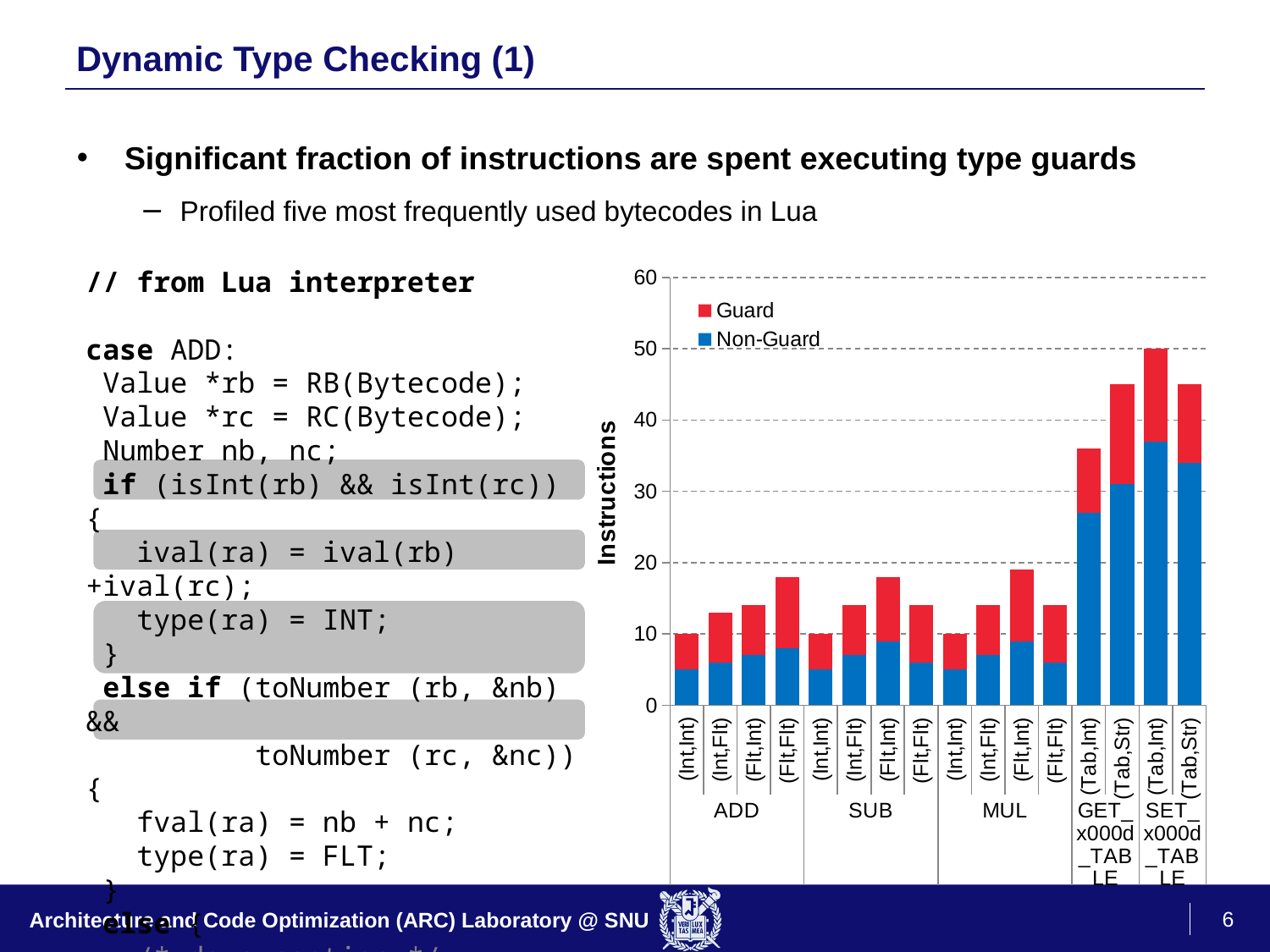
Is the total value for SET_TABLE (Tab,Int) greater or less than 40? greater Is the total value for GET_TABLE (Tab,Int) greater or less than 30? greater Is the total value for ADD (Flt,Flt) greater or less than 20? less What are the two series named in the chart legend? Guard and Non-Guard How many bars are plotted in the chart? 16 How many series does the chart legend list? 2 Which bar has the highest total number of instructions? SET_TABLE (Tab,Int) Which has a larger total, GET_TABLE (Tab,Int) or GET_TABLE (Tab,Str)? GET_TABLE (Tab,Str) Which has a larger total, ADD (Int,Int) or ADD (Flt,Flt)? ADD (Flt,Flt) What is the label of the vertical axis of the chart? Instructions What kind of chart is shown on the slide? stacked bar chart